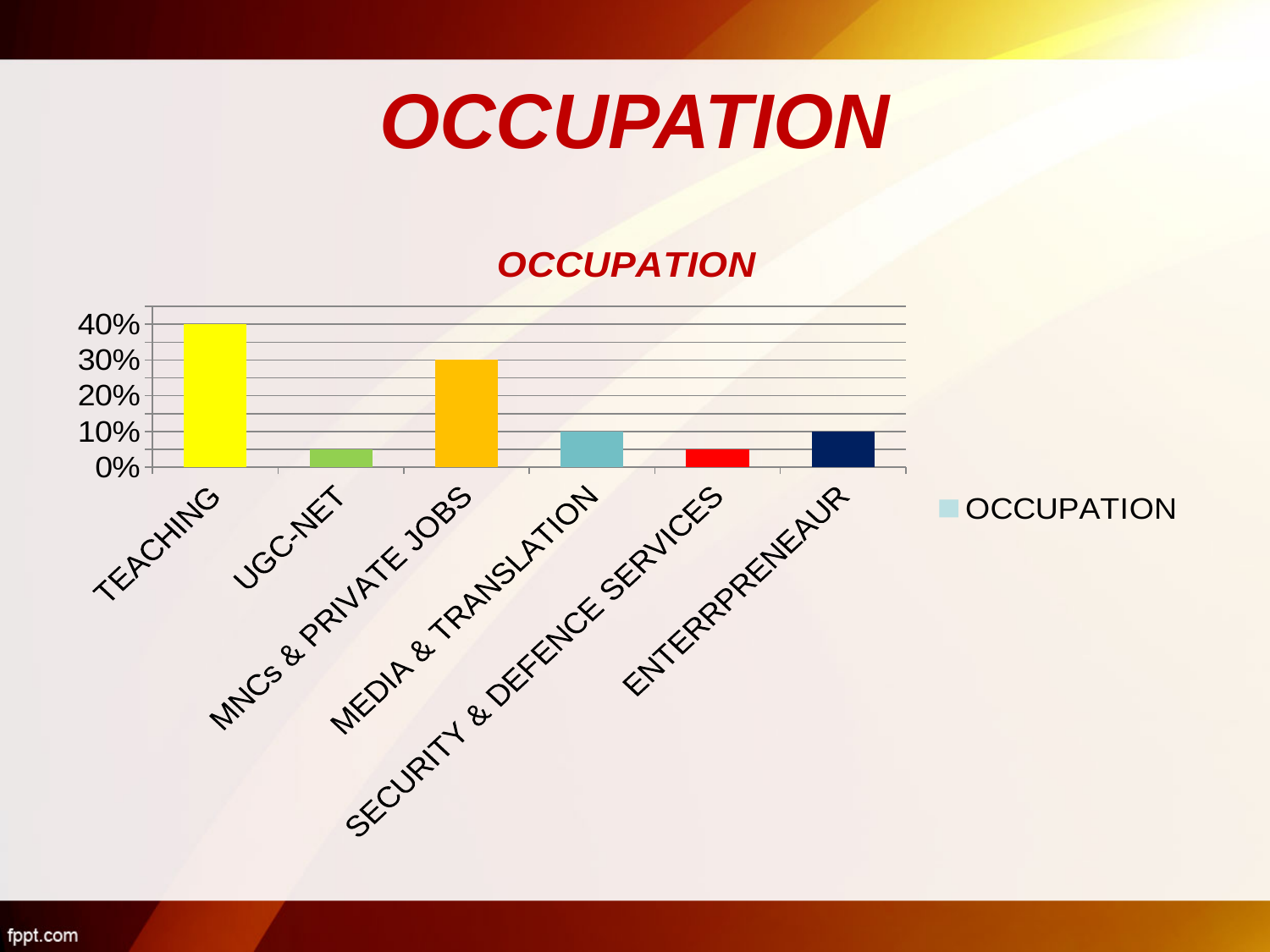
How many occupation categories are shown on the x axis? 6 What is the value for TEACHING? 40% Which occupation has the highest value? TEACHING What is the title of the chart? OCCUPATION What type of chart is shown on the slide? bar chart What is the difference between the values for TEACHING and MNCs & PRIVATE JOBS? 10% What is the value for MEDIA & TRANSLATION? 10% Is the value for UGC-NET greater or less than 10%? less Which is larger, the value for MNCs & PRIVATE JOBS or the value for ENTERRPRENEAUR? MNCs & PRIVATE JOBS What is the value for MNCs & PRIVATE JOBS? 30% Is the value for SECURITY & DEFENCE SERVICES greater or less than 10%? less How many series does the legend list? 1